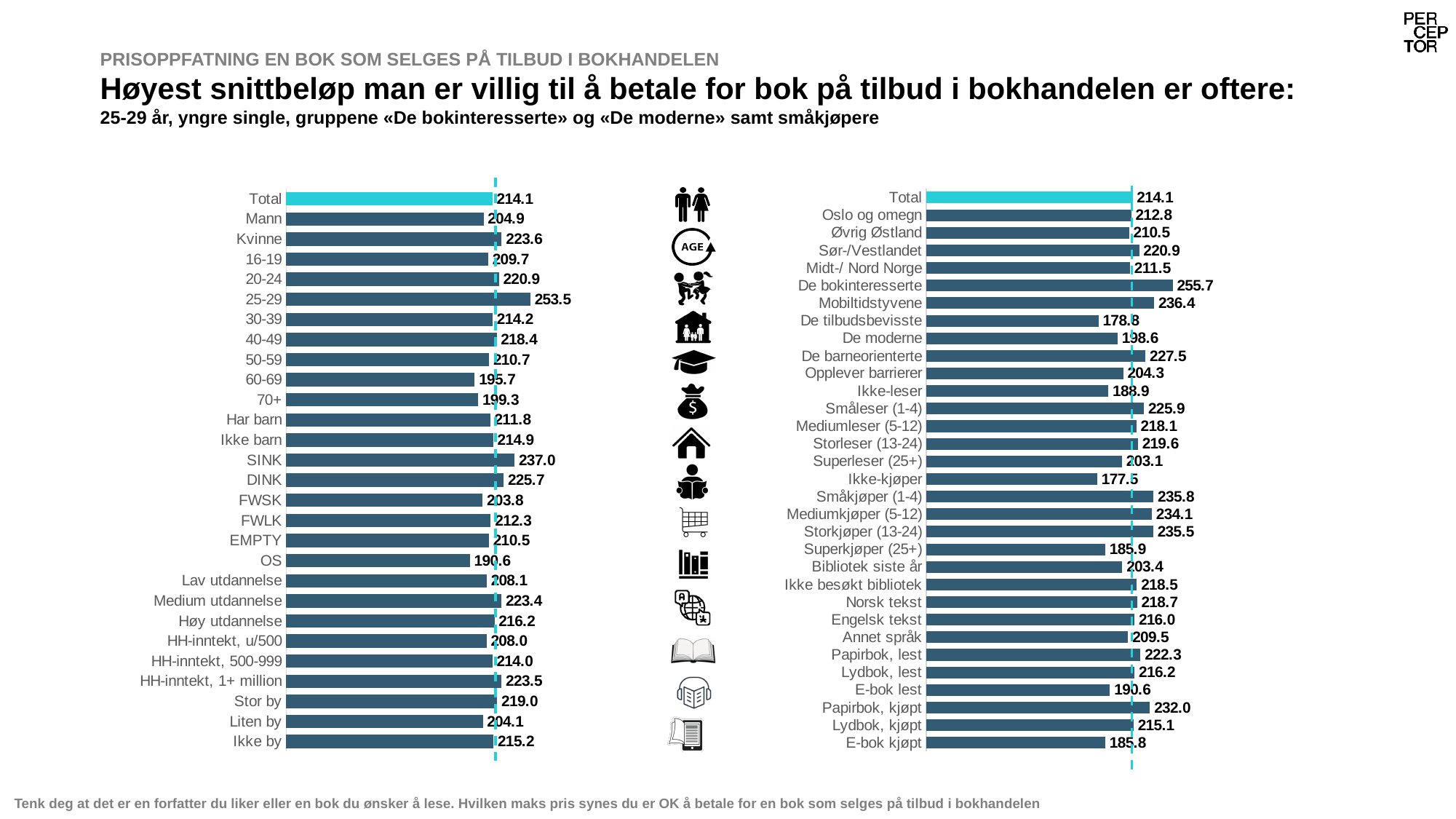
In the right chart, which is larger: the value for Papirbok, kjøpt or the value for E-bok kjøpt? Papirbok, kjøpt In the right chart, which category has the highest value? De bokinteresserte In the right chart, what is the value for De bokinteresserte? 255.7 In the left chart, which category has the highest value? 25-29 How many categories are shown in the right chart? 32 What type of chart is the left chart? Bar chart In the left chart, what is the difference between the values for Kvinne and Mann? 18.7 In the left chart, which is larger: the value for SINK or the value for DINK? SINK In the right chart, which category has the lowest value? Ikke-kjøper In the left chart, what is the value for 25-29? 253.5 In the right chart, what is the difference between the values for Mobiltidstyvene and De tilbudsbevisste? 57.6 In the left chart, which category has the lowest value? OS